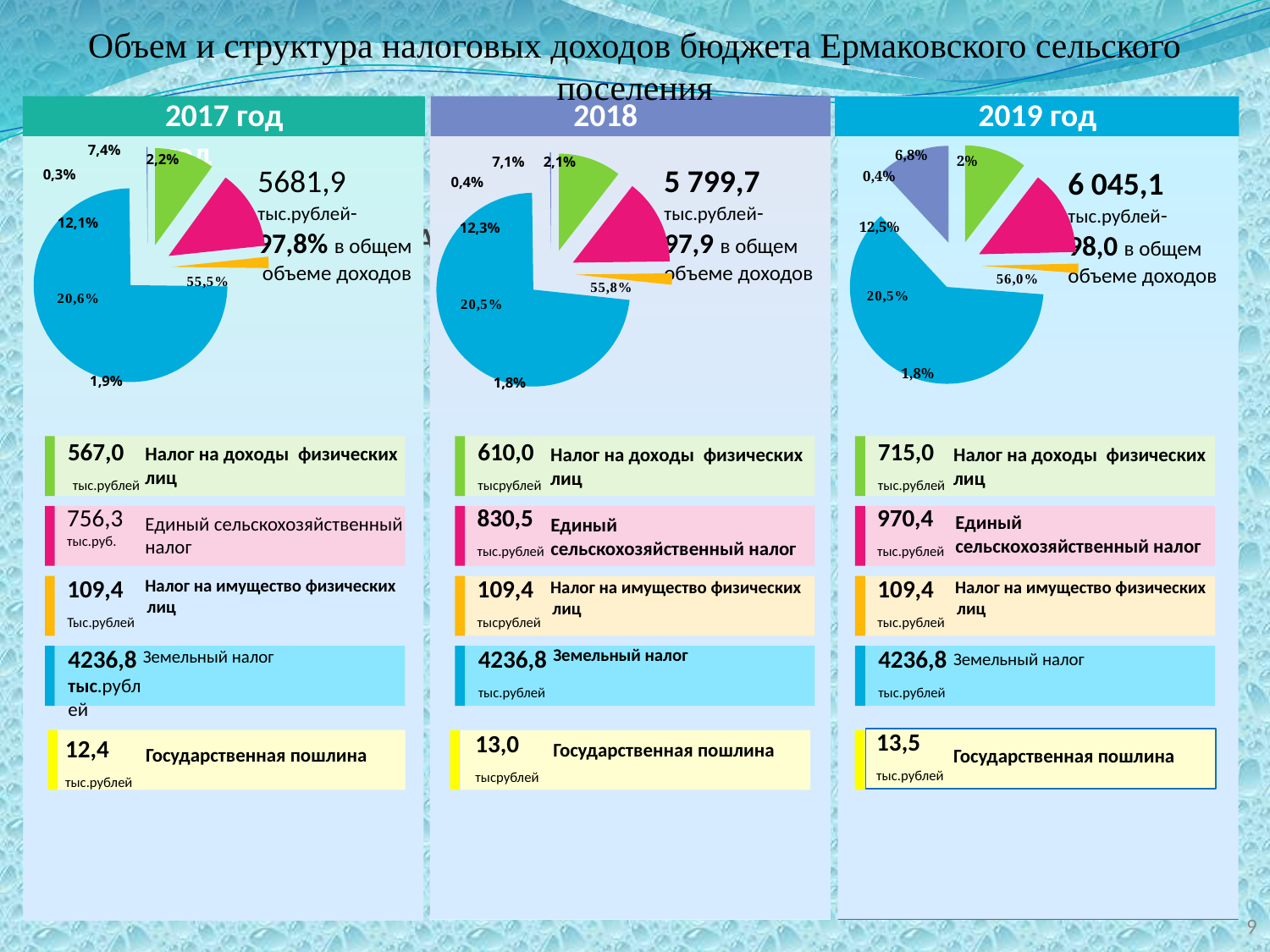
In the 2017 год pie chart, what is the smallest labelled share? 0,3% What colour is the largest slice in the 2018 pie chart? blue By how many percentage points does the largest slice of the 2019 год pie chart exceed the largest slice of the 2017 год pie chart? 0,5 In the 2018 pie chart, what is the largest labelled share? 55,8% What kind of chart is used for the 2017 год panel? pie chart How many labelled slices does the 2019 год pie chart have? 7 How many labelled slices does the 2018 pie chart have? 7 In the 2017 год pie chart, what is the largest labelled share? 55,5% Which is larger: the 12,1% slice in the 2017 год pie chart or the 12,5% slice in the 2019 год pie chart? 12,5% in 2019 In the 2019 год pie chart, what is the largest labelled share? 56,0% In the 2019 год pie chart, what is the smallest labelled share? 0,4% Does the largest slice share rise or fall from the 2017 год pie chart to the 2019 год pie chart? rise